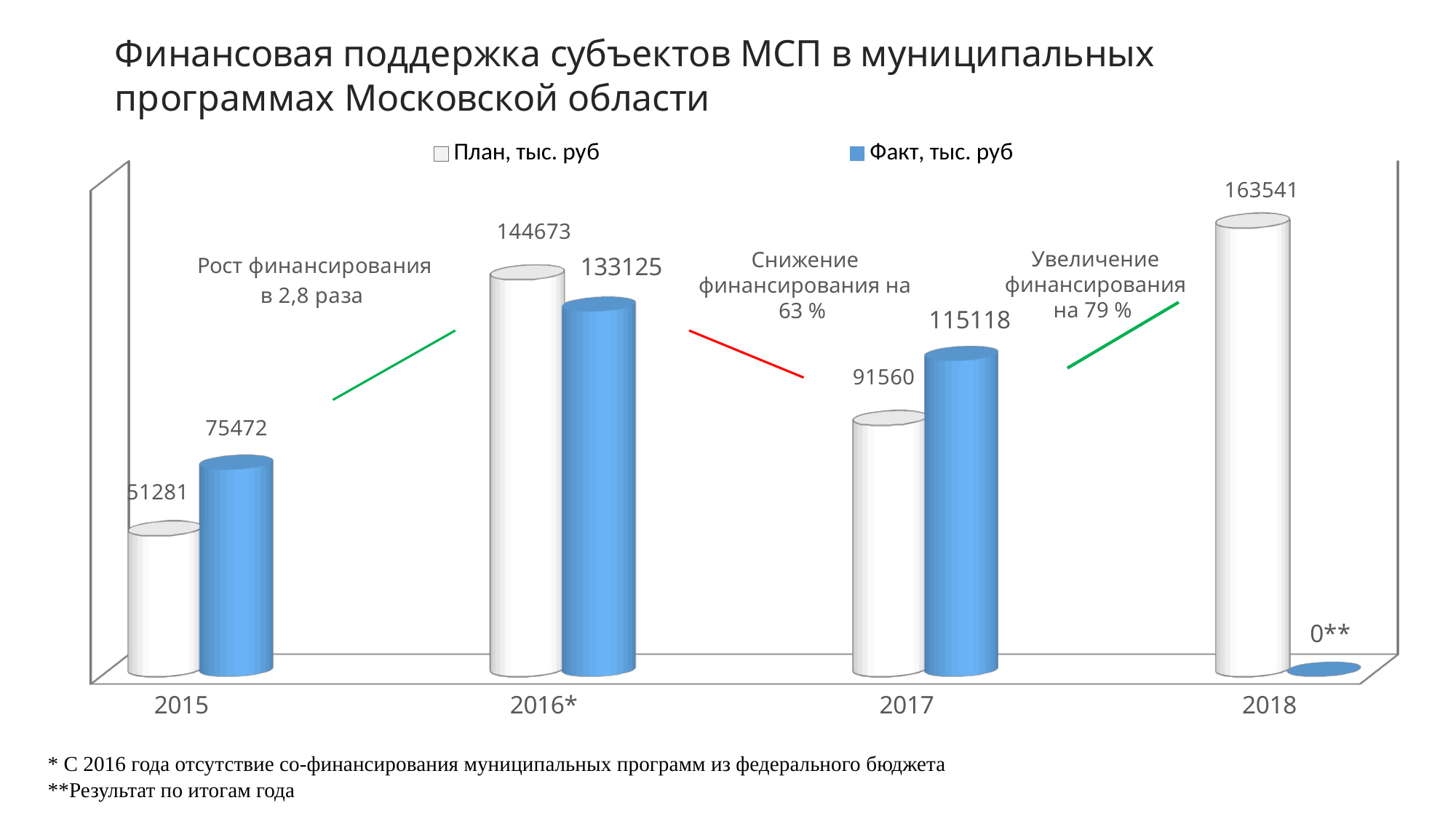
Which year has the highest planned value (План, тыс. руб)? 2018 What is the planned value (План, тыс. руб) for 2018? 163541 How many series does the legend list? 2 Which year has the lowest actual value (Факт, тыс. руб)? 2018 Which is larger for 2017: the planned value or the actual value? the actual value (Факт) What is the difference between the planned and actual values for 2016*? 11548 What are the two series named in the legend? План, тыс. руб and Факт, тыс. руб What is the actual value (Факт, тыс. руб) for 2017? 115118 How many years are shown on the x axis? 4 What is the planned value (План, тыс. руб) for 2015? 51281 What kind of chart is shown on the slide? bar chart What is the actual value (Факт, тыс. руб) for 2016*? 133125